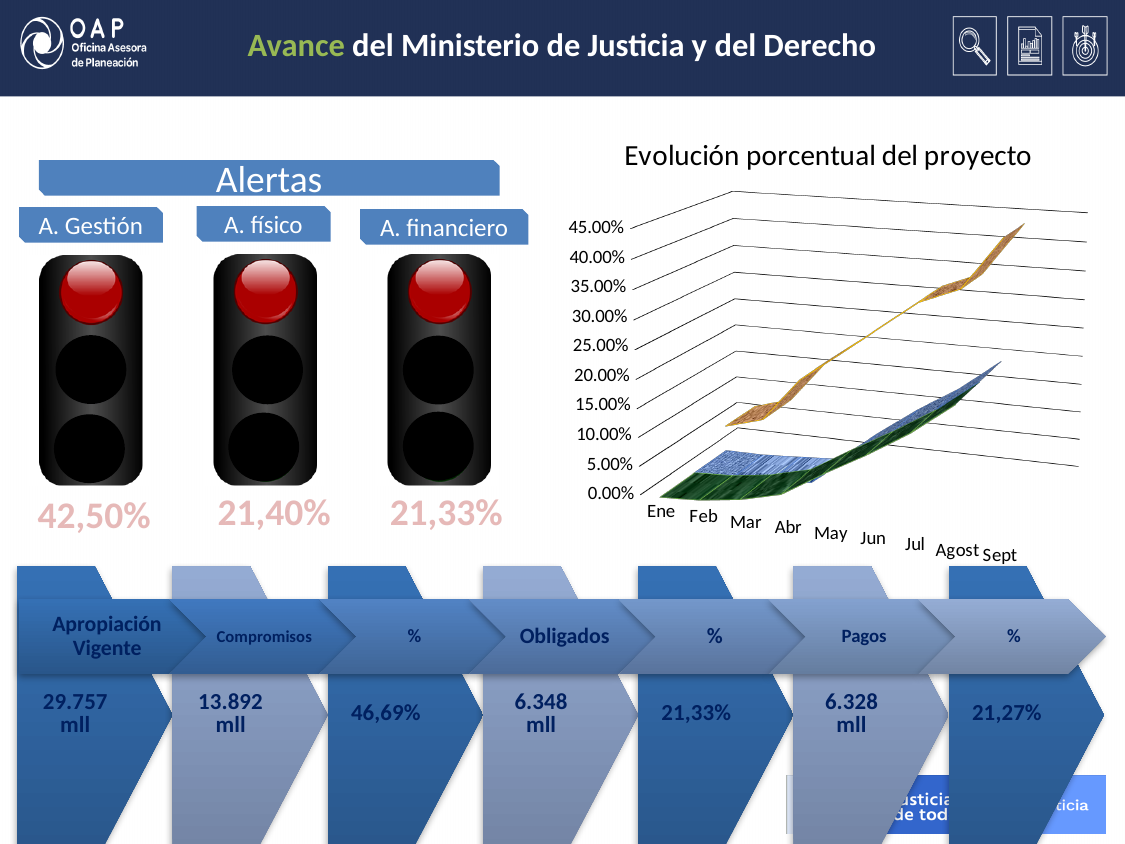
What is the first month shown on the x axis of the 'Evolución porcentual del proyecto' chart? Ene What is the title of the chart on the right side of the slide? Evolución porcentual del proyecto What is the lowest tick value on the vertical axis of the 'Evolución porcentual del proyecto' chart? 0.00% What kind of chart is 'Evolución porcentual del proyecto'? 3D line chart How many data series are plotted in the 'Evolución porcentual del proyecto' chart? 3 In the 'Evolución porcentual del proyecto' chart, do the values rise or fall from Ene to Sept? rise How many months are shown on the x axis of the 'Evolución porcentual del proyecto' chart? 9